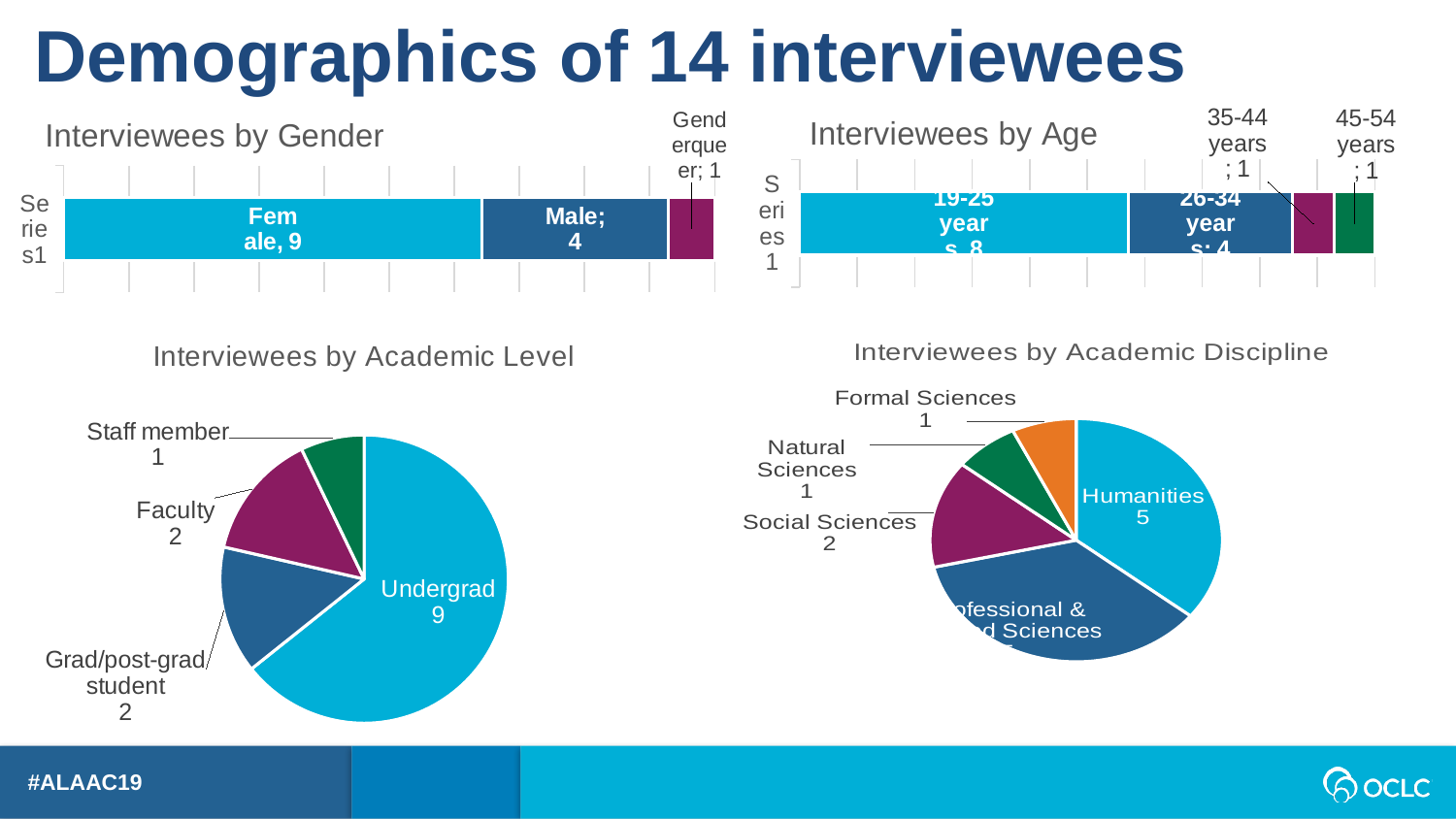
In the Interviewees by Academic Level chart, how many interviewees are undergrads? 9 In the Interviewees by Gender chart, how many interviewees are female? 9 In the Interviewees by Gender chart, what is the total number of interviewees across the stacked bar? 14 In the Interviewees by Academic Discipline chart, how many interviewees are in Social Sciences? 2 In the Interviewees by Age chart, which age group has the most interviewees? 19-25 years In the Interviewees by Age chart, how many interviewees are 19-25 years old? 8 In the Interviewees by Academic Level chart, which category has the fewest interviewees? Staff member In the Interviewees by Age chart, how many age groups are shown? 4 What kind of chart is Interviewees by Academic Level? Pie chart In the Interviewees by Age chart, which is larger, the 26-34 years count or the 35-44 years count? 26-34 years What kind of chart is Interviewees by Gender? Bar chart In the Interviewees by Gender chart, what is the difference between the Female and Male counts? 5